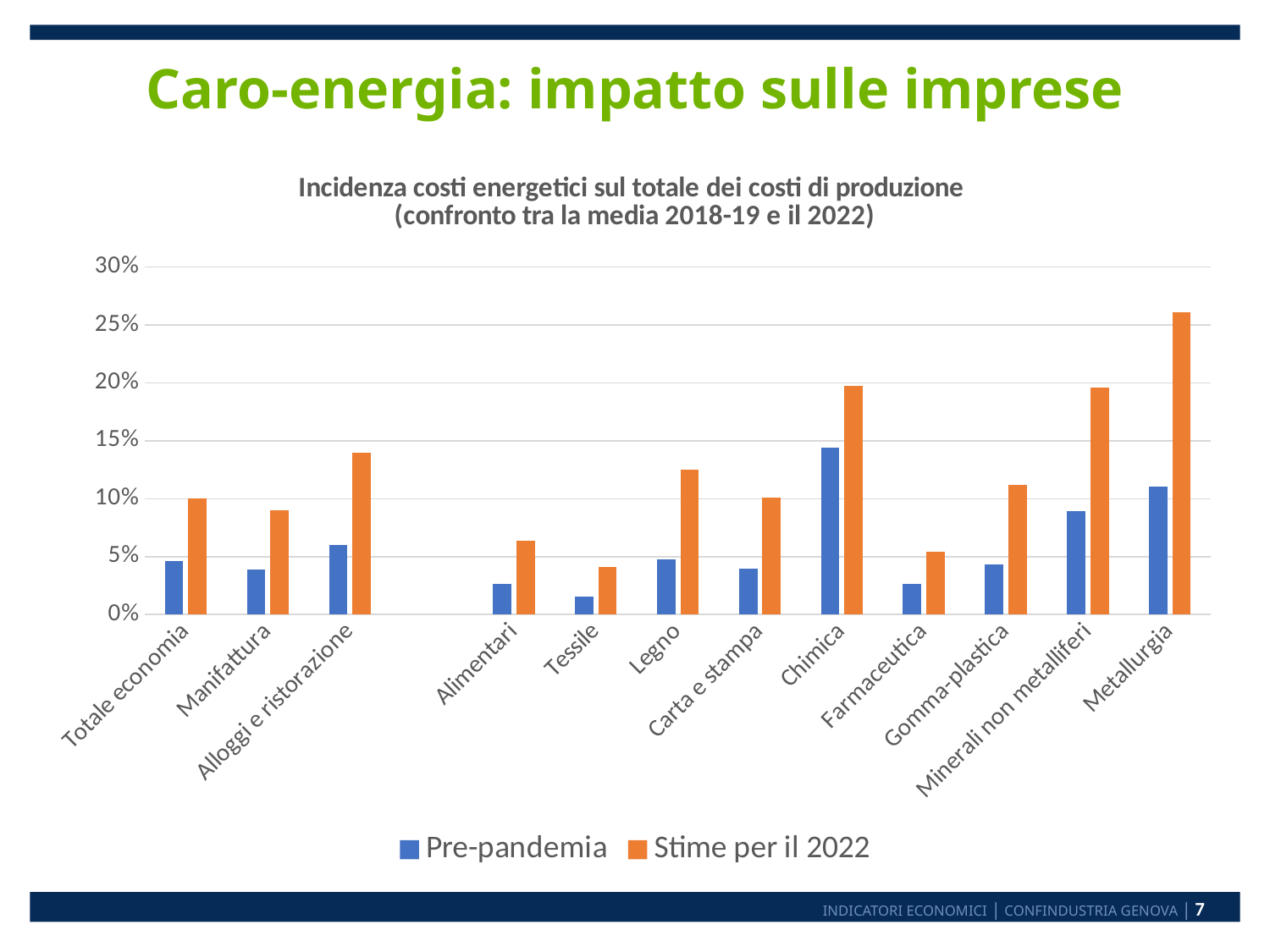
What are the two series named in the legend? Pre-pandemia and Stime per il 2022 Which category has the lowest value for Pre-pandemia? Tessile Is the Stime per il 2022 value for Legno greater or less than 10%? greater What kind of chart is shown on the slide? Bar chart Which is larger for Pre-pandemia: Chimica or Metallurgia? Chimica Which category has the highest value for Stime per il 2022? Metallurgia How many series does the legend list? 2 How many labeled categories are shown on the x axis? 12 Is the Stime per il 2022 value for Metallurgia greater or less than 25%? greater Is the Pre-pandemia value for Chimica greater or less than 15%? less Which category has the highest value for Pre-pandemia? Chimica Which category has the lowest value for Stime per il 2022? Tessile